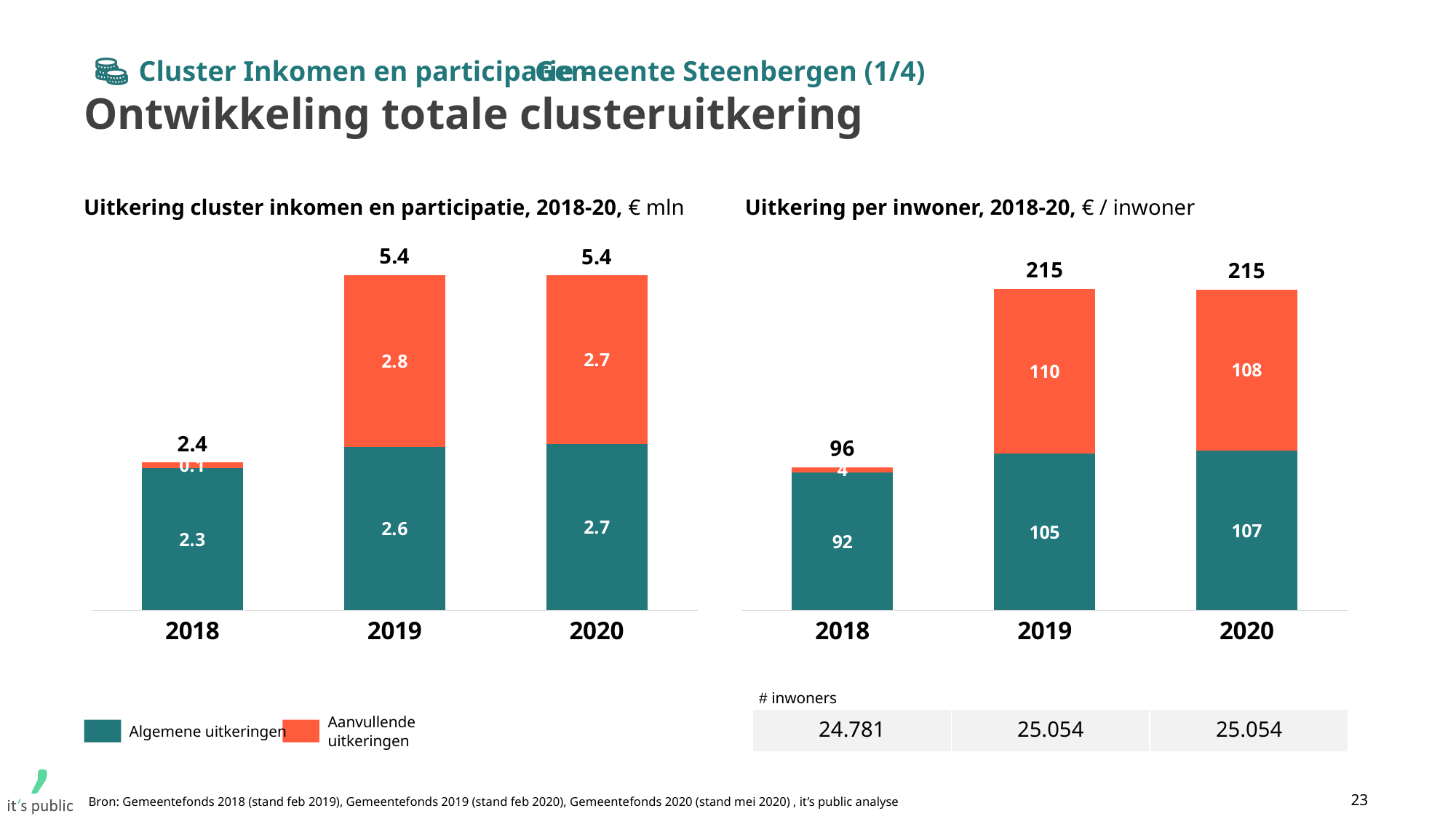
How many years are shown on the x axis of the left chart (Uitkering cluster inkomen en participatie)? 3 In the right chart (Uitkering per inwoner), which is larger for 2019: Algemene uitkeringen or Aanvullende uitkeringen? Aanvullende uitkeringen What kind of chart is the right chart (Uitkering per inwoner)? Stacked bar chart In the left chart (Uitkering cluster inkomen en participatie), what is the total of the stacked bar for 2018? 2.4 In the left chart (Uitkering cluster inkomen en participatie), what is the value of Algemene uitkeringen for 2019? 2.6 In the right chart (Uitkering per inwoner), what is the total of the stacked bar for 2020? 215 In the left chart (Uitkering cluster inkomen en participatie), what is the value of Aanvullende uitkeringen for 2020? 2.7 How many series does the legend list for the charts on this slide? 2 In the left chart (Uitkering cluster inkomen en participatie), what is the difference between the Aanvullende uitkeringen values for 2019 and 2018? 2.7 In the right chart (Uitkering per inwoner), which year has the lowest total? 2018 In the right chart (Uitkering per inwoner), what is the value of Aanvullende uitkeringen for 2019? 110 In the right chart (Uitkering per inwoner), what is the value of Algemene uitkeringen for 2018? 92